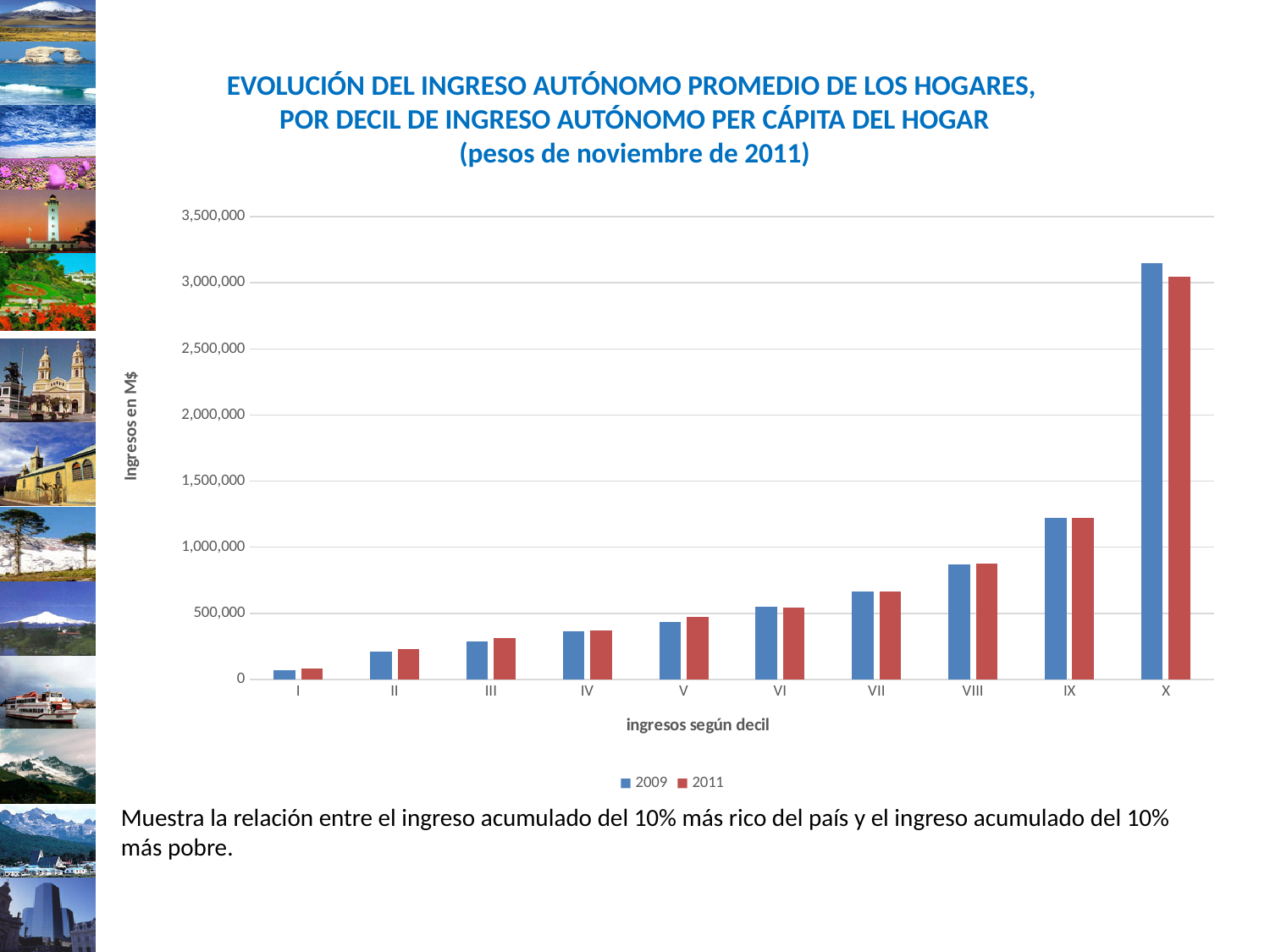
How many deciles (categories) are shown on the x axis? 10 How many series does the legend list? 2 What is the label of the y axis? Ingresos en M$ Which decil has the highest income for 2011? X What kind of chart is shown on the slide? bar chart Do the values rise or fall as you move from decil I to decil X? rise Which decil has the lowest income for 2009? I Is the 2011 value for decil IX greater or less than 1,000,000? greater Is the 2009 value for decil VIII greater or less than 1,000,000? less For decil X, which series has the larger value, 2009 or 2011? 2009 Is the 2009 value for decil X greater or less than 3,000,000? greater